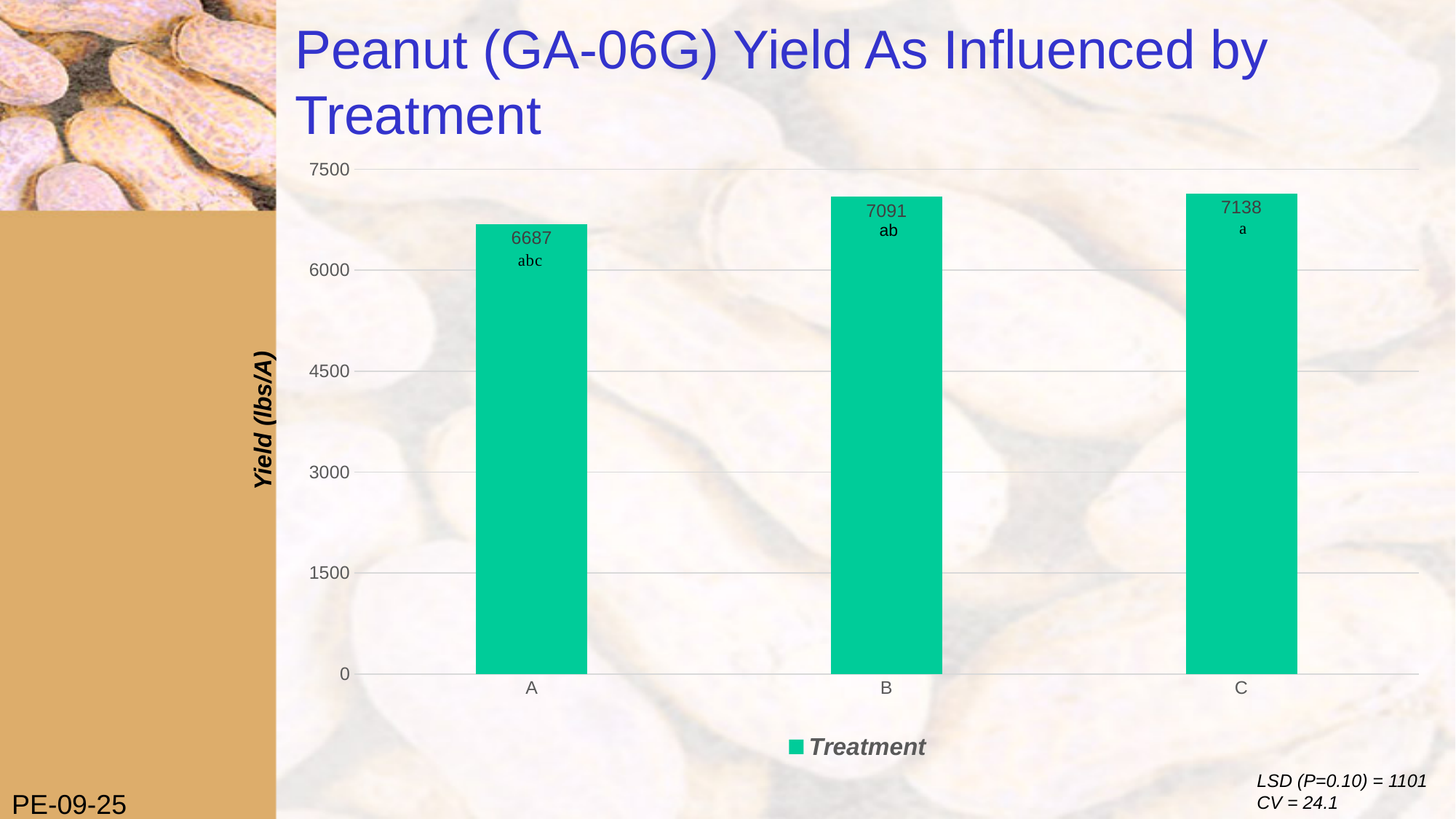
What is the yield value for treatment A? 6687 What is the label of the y axis? Yield (lbs/A) Which has a larger yield, treatment A or treatment B? B What is the difference in yield between treatment B and treatment A? 404 What is the difference in yield between treatment C and treatment A? 451 Which treatment has the lowest yield? A What kind of chart is shown on the slide? bar chart What is the yield value for treatment C? 7138 How many treatments are shown on the x axis? 3 What is the yield value for treatment B? 7091 Which treatment has the highest yield? C Is the yield for treatment A greater or less than 6000? greater